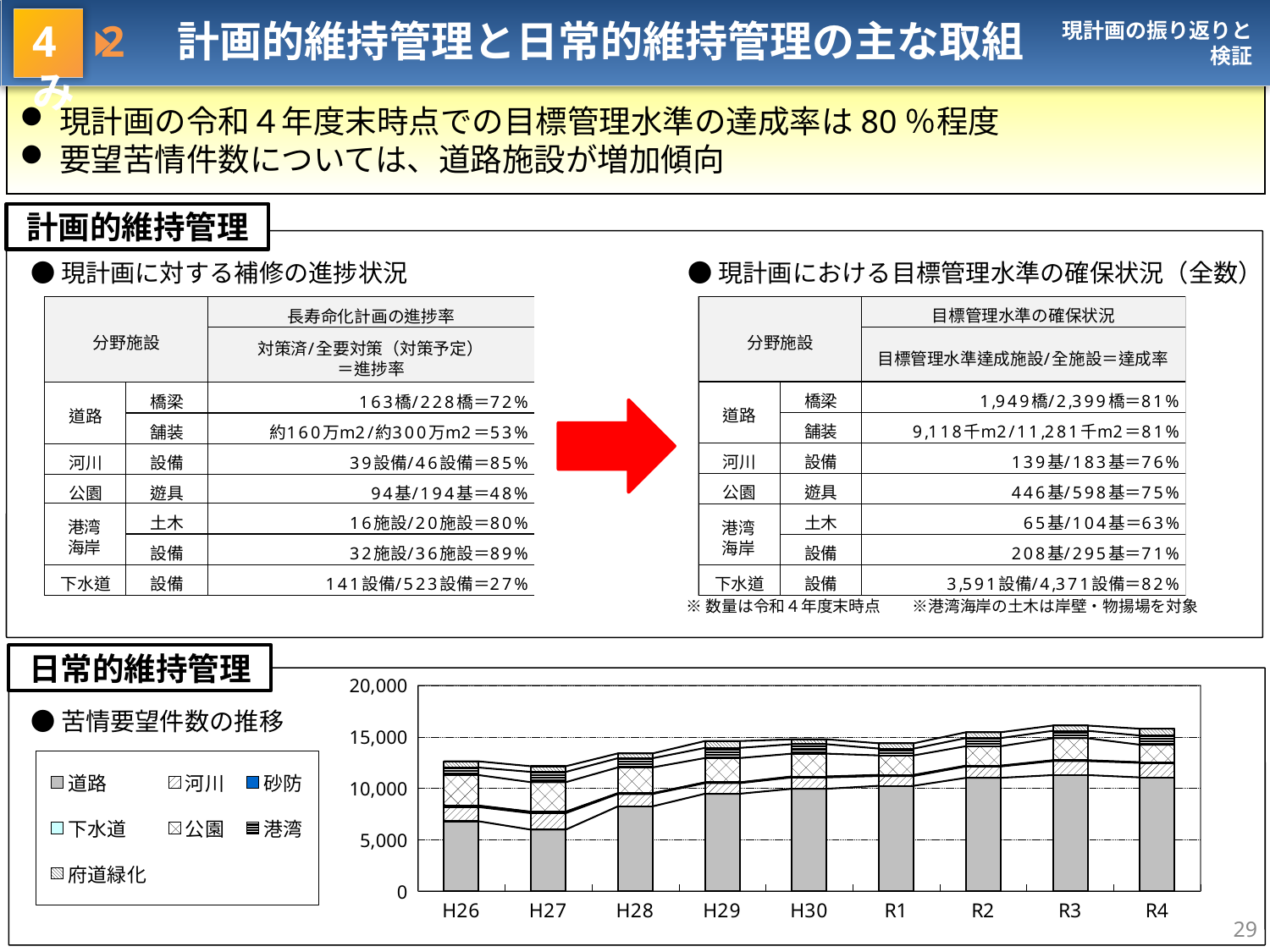
How many series does the legend of the 苦情要望件数の推移 chart list? 7 Is the 道路 value for H27 in the 苦情要望件数の推移 chart greater or less than 10,000? less Is the total stacked value for R3 in the 苦情要望件数の推移 chart greater or less than 15,000? greater Is the 道路 value for R3 in the 苦情要望件数の推移 chart greater or less than 10,000? greater How many fiscal years are shown on the x axis of the 苦情要望件数の推移 chart? 9 Which fiscal year has the lowest total stacked value in the 苦情要望件数の推移 chart? H27 Overall, do the total stacked values in the 苦情要望件数の推移 chart rise or fall from H26 to R4? rise Which fiscal year is the first category on the x axis of the 苦情要望件数の推移 chart? H26 What kind of chart is shown in the 日常的維持管理 section? stacked bar chart Which series forms the bottom segment of each bar in the 苦情要望件数の推移 chart? 道路 Which has the larger total stacked value in the 苦情要望件数の推移 chart, H26 or R4? R4